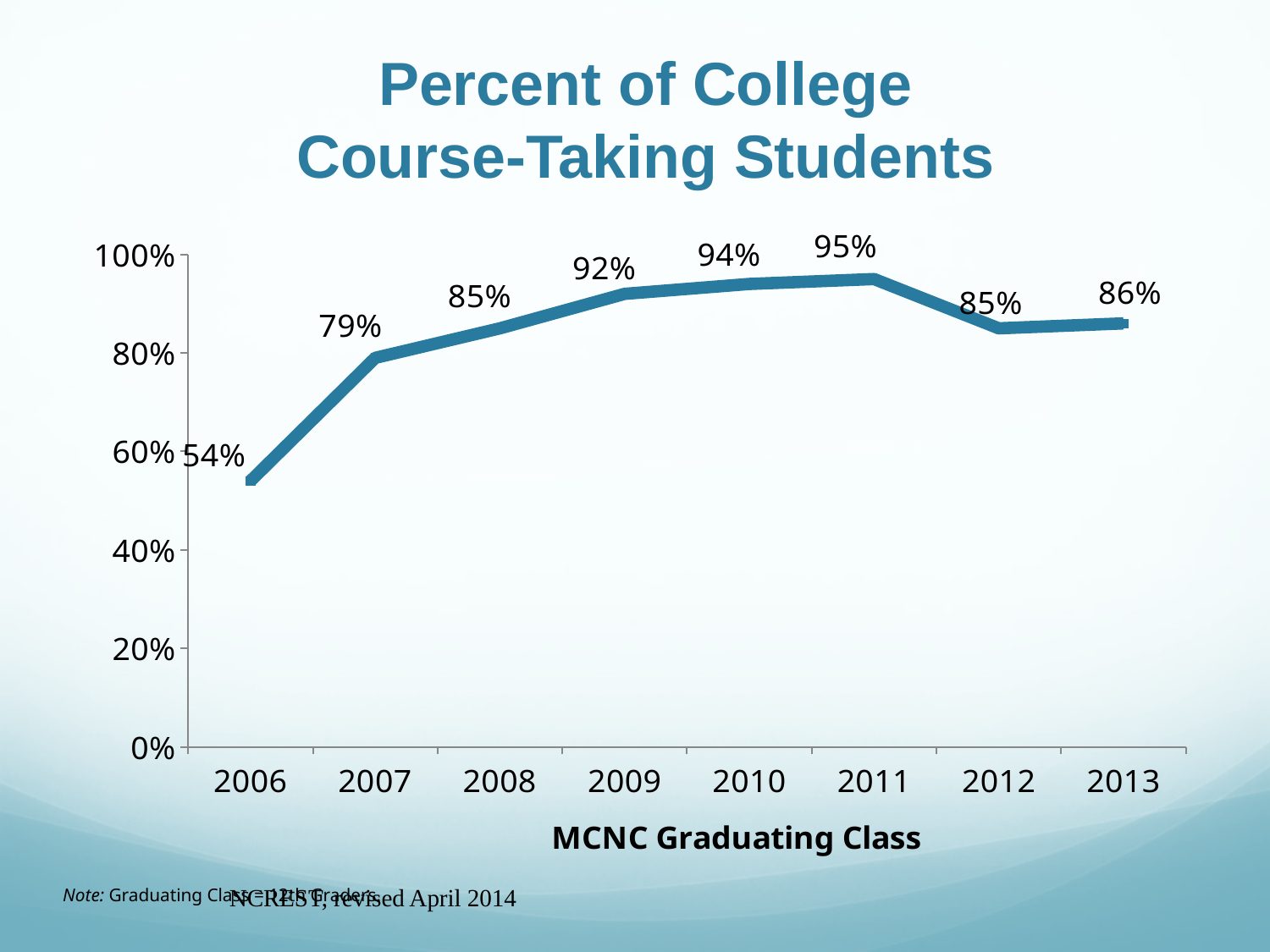
What is the value shown for the 2013 graduating class? 86% How many graduating classes are plotted on the chart? 8 What kind of chart is shown on the slide? Line chart Which graduating class has the lowest percent of college course-taking students? 2006 What is the value shown for the 2011 graduating class? 95% Is the value for 2007 greater or less than 60%? greater What is the difference between the values for 2012 and 2013? 1% What is the percent of college course-taking students for the 2006 graduating class? 54% What is the difference between the values for 2011 and 2006? 41% What is the label of the x axis? MCNC Graduating Class Which graduating class has the highest percent of college course-taking students? 2011 Which is larger, the value for 2009 or the value for 2012? 2009